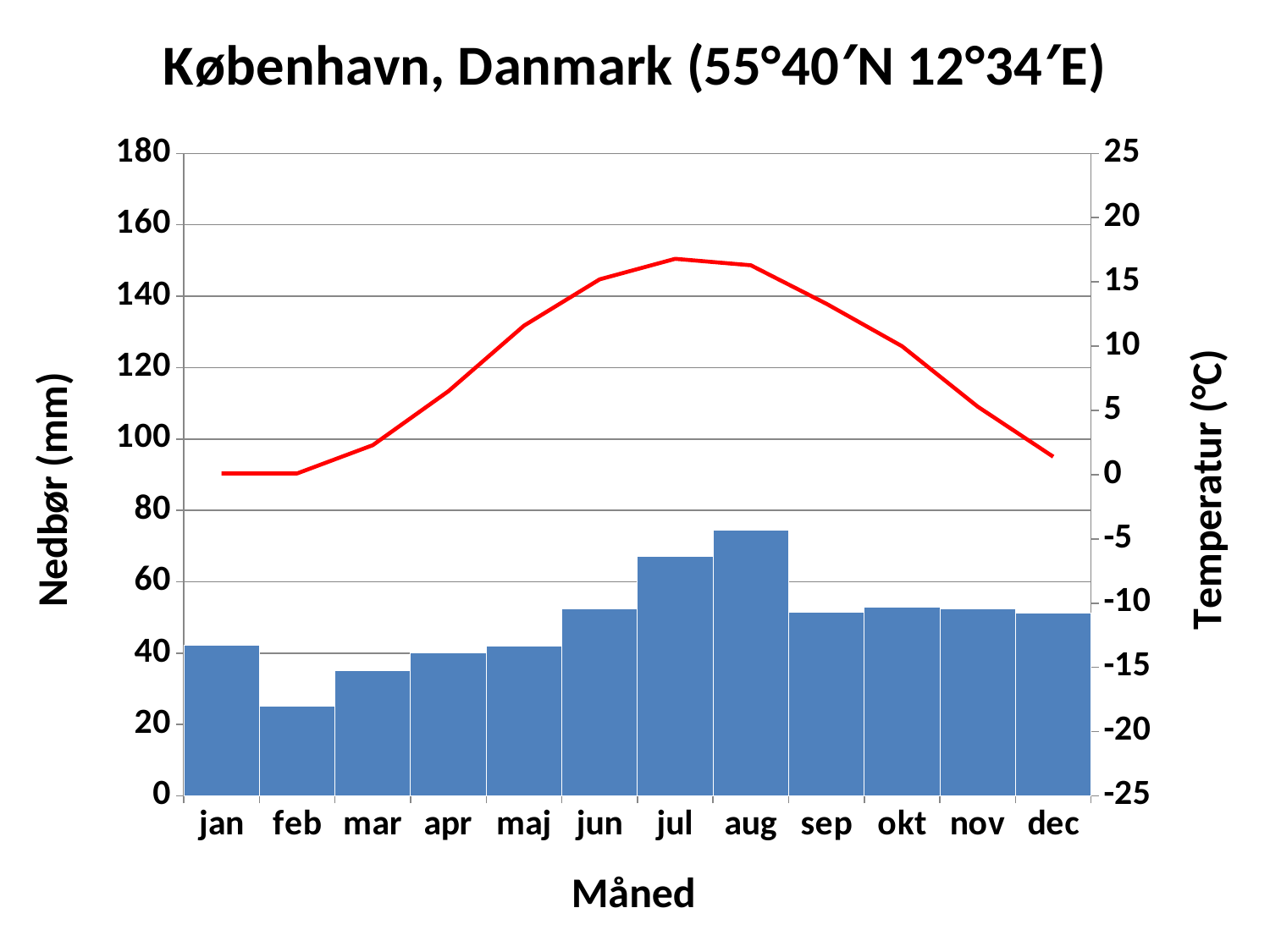
Which month has the highest precipitation (Nedbør) bar? aug Is the temperature value for jan greater or less than 5 °C? less Which month has the highest temperature on the red line? jul Which month has a higher precipitation bar, jul or feb? jul Which month has a higher temperature, maj or nov? maj Which month has the lowest precipitation (Nedbør) bar? feb What is the title of the chart? København, Danmark (55°40′N 12°34′E) Is the precipitation value for feb greater or less than 40 mm? less Does the temperature line rise or fall from jan to jul? rise How many months are shown on the x axis? 12 Is the precipitation value for aug greater or less than 60 mm? greater